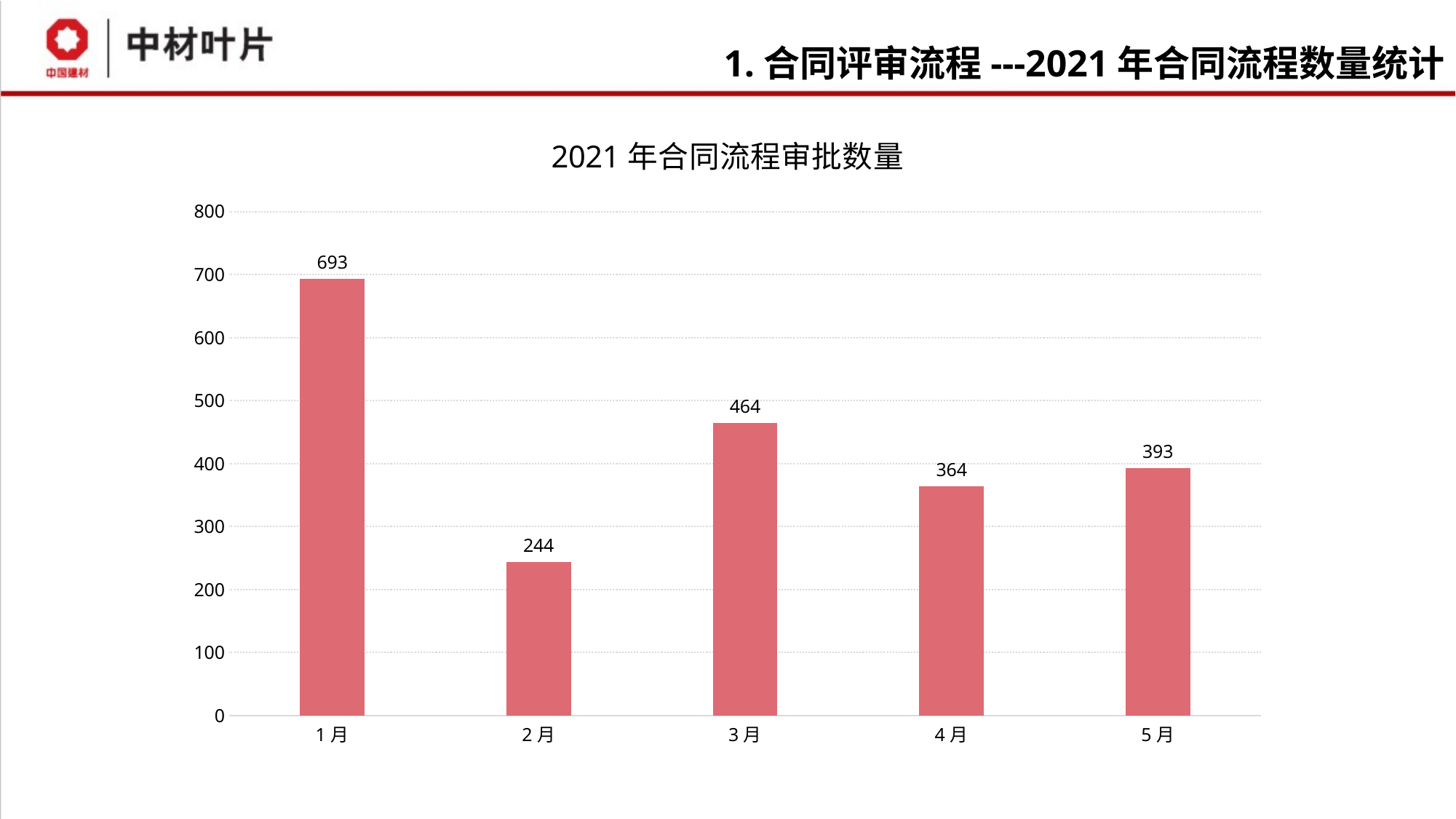
What is the value for 5月? 393 How many months are shown on the x axis? 5 What is the difference between the values for 3月 and 4月? 100 What kind of chart is shown on the slide? Bar chart Which is larger, the value for 4月 or the value for 5月? 5月 What is the difference between the values for 1月 and 2月? 449 Which month has the lowest value? 2月 What is the value for 1月? 693 What is the value for 3月? 464 What is the value for 2月? 244 Which month has the highest value? 1月 What is the title of the chart? 2021 年合同流程审批数量